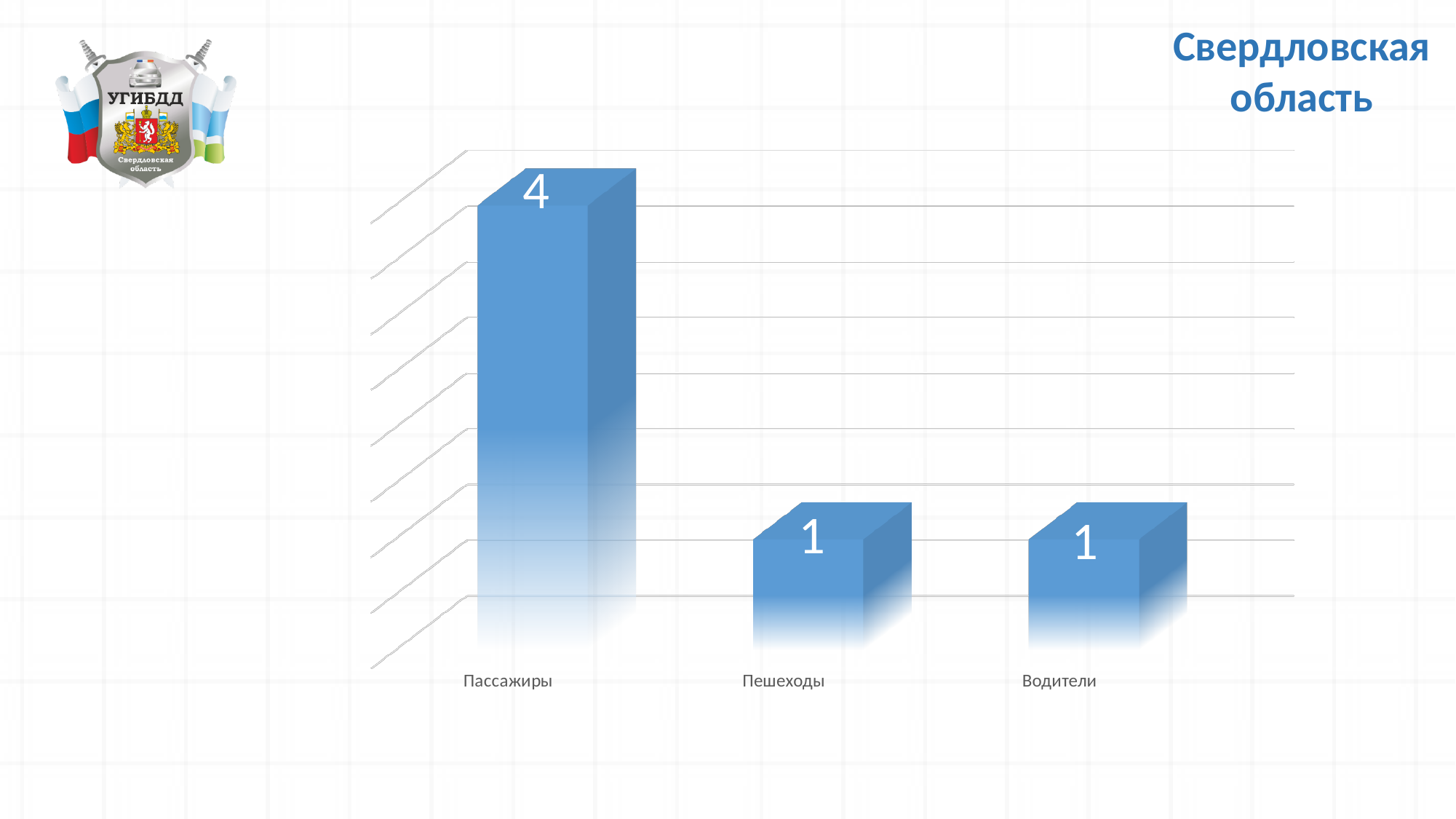
What colour are the bars in the chart? blue How many categories are shown on the x axis? 3 What is the value for Водители? 1 What is the value for Пассажиры? 4 What is the difference between the values for Пассажиры and Пешеходы? 3 Which category has the highest value? Пассажиры Which category is labelled on the far right of the x axis? Водители Which is larger, the value for Пассажиры or the value for Водители? Пассажиры What is the value for Пешеходы? 1 What kind of chart is shown on the slide? bar chart What is the total of the values for all three categories? 6 Do the values for Пешеходы and Водители differ? No, both are 1